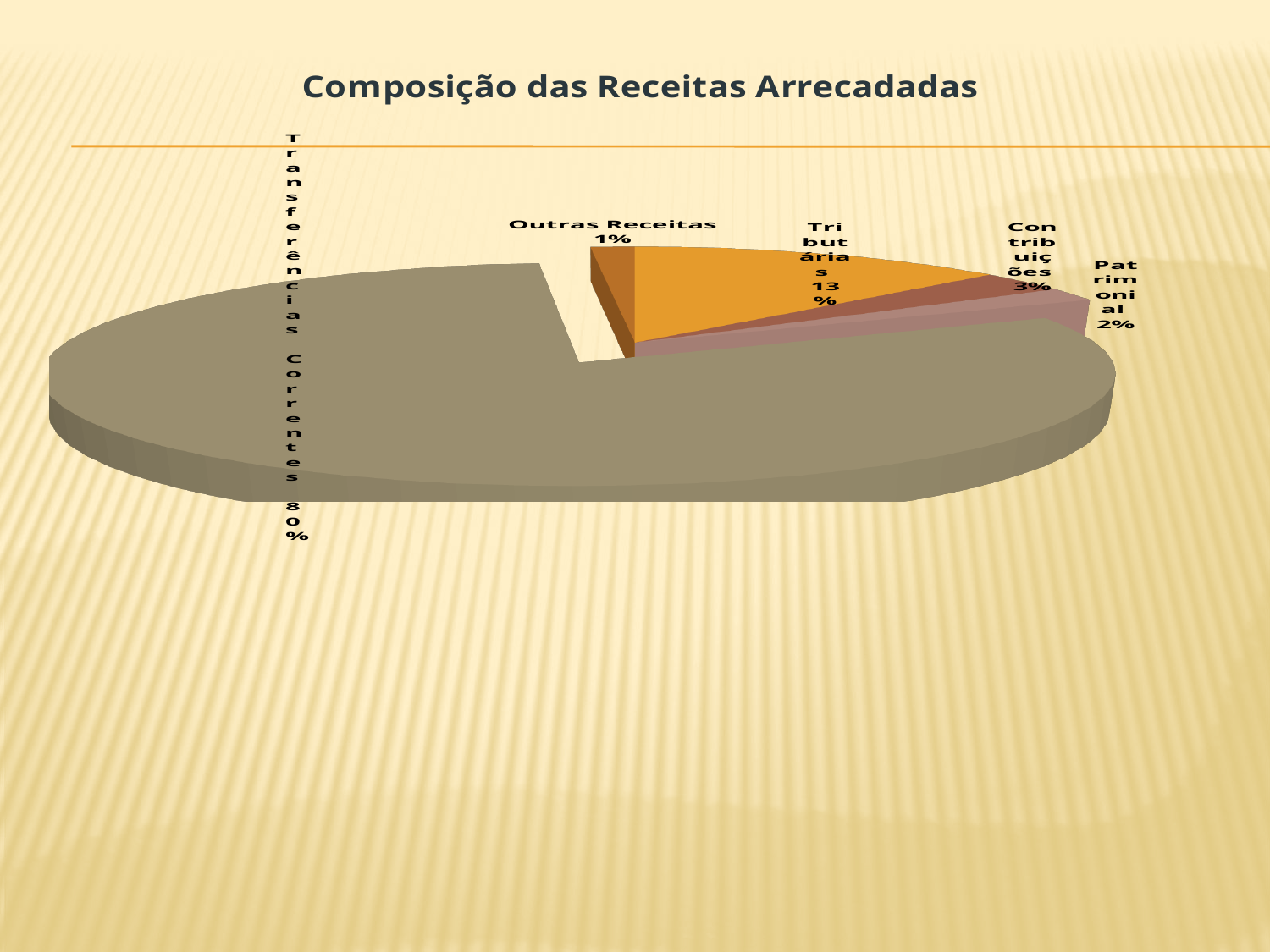
What is the title of the chart? Composição das Receitas Arrecadadas What share of the pie is Contribuições? 3% Which category has the smallest slice of the pie? Outras Receitas Which is larger, the share of Contribuições or the share of Patrimonial? Contribuições What share of the pie is Patrimonial? 2% What share of the pie is Tributárias? 13% Which category has the largest slice of the pie? Transferências Correntes What kind of chart is shown on the slide? pie chart How many slices does the pie chart have? 5 What share of the pie is Outras Receitas? 1% What share of the pie is Transferências Correntes? 80% What is the difference between the shares of Transferências Correntes and Tributárias? 67%